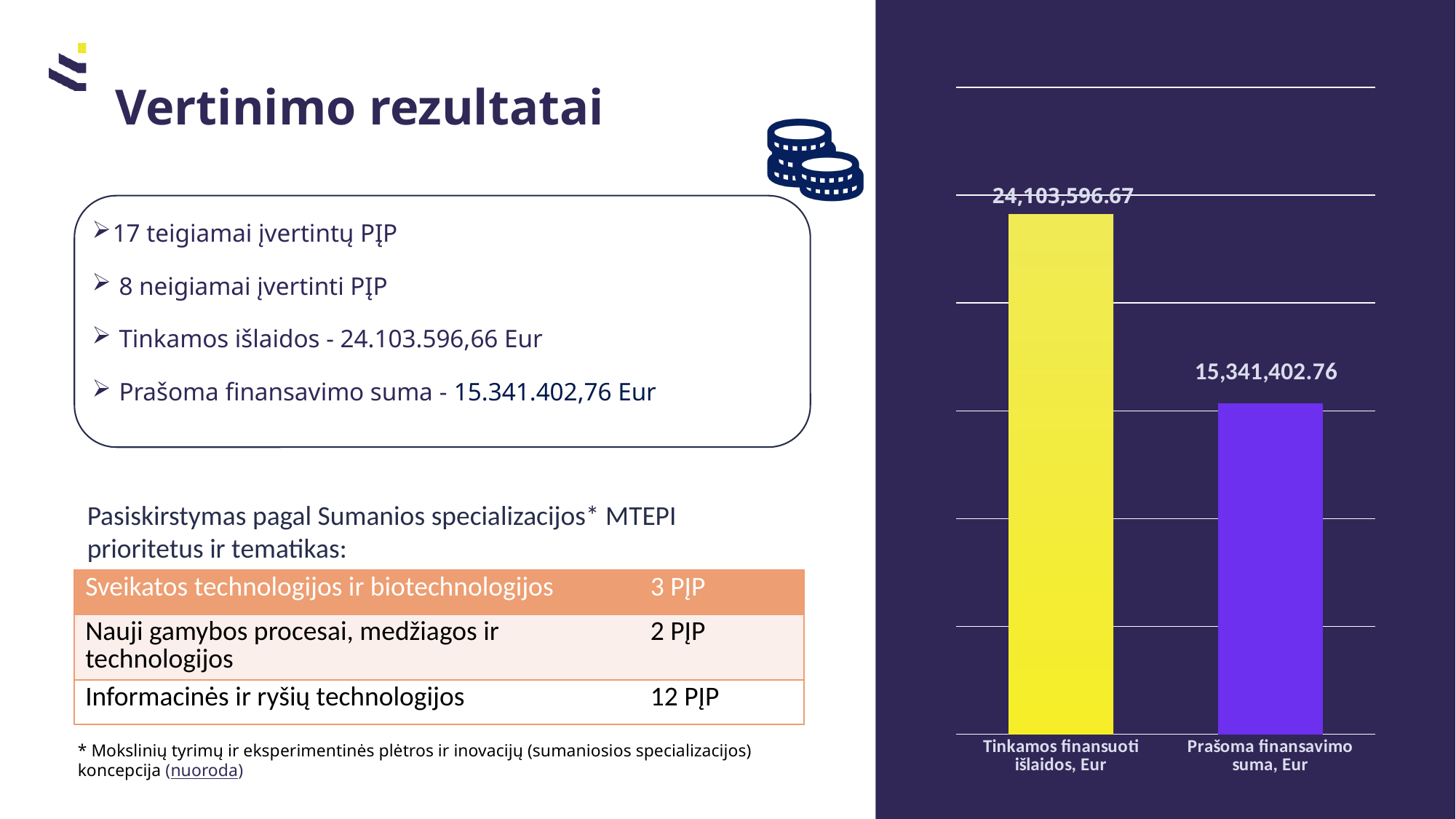
Which is larger: the value for Tinkamos finansuoti išlaidos, Eur or the value for Prašoma finansavimo suma, Eur? Tinkamos finansuoti išlaidos, Eur How many categories are shown in the chart? 2 What is the value for Tinkamos finansuoti išlaidos, Eur? 24,103,596.67 What kind of chart is shown on the slide? bar chart What is the value for Prašoma finansavimo suma, Eur? 15,341,402.76 Which category has the highest value? Tinkamos finansuoti išlaidos, Eur What is the difference between the value for Tinkamos finansuoti išlaidos, Eur and the value for Prašoma finansavimo suma, Eur? 8,762,193.91 What colour is the bar for Tinkamos finansuoti išlaidos, Eur? yellow Do the values rise or fall from left to right along the x axis? fall Which category has the lowest value? Prašoma finansavimo suma, Eur What colour is the bar for Prašoma finansavimo suma, Eur? purple